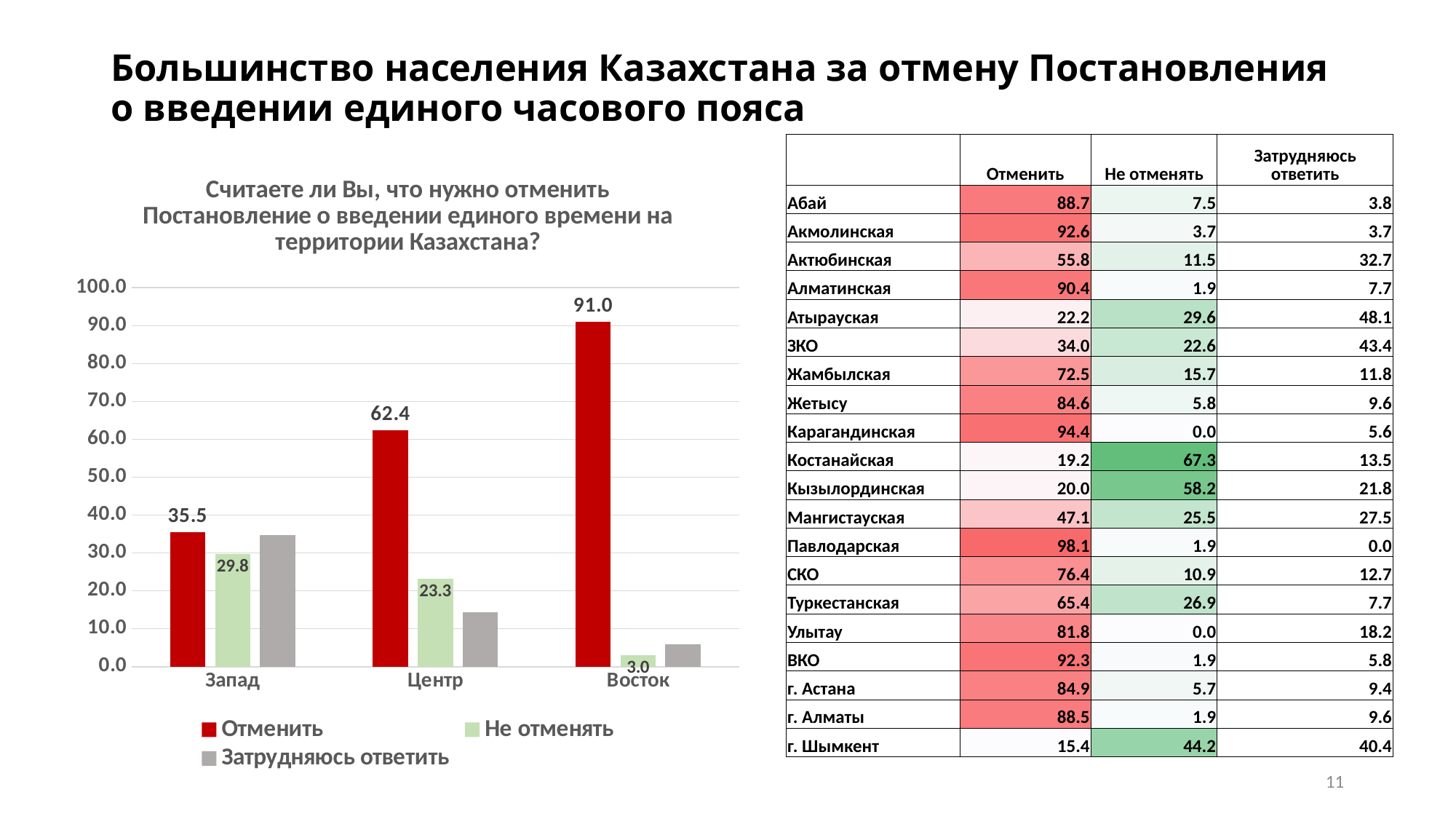
Is the value of Затрудняюсь ответить for Восток greater or less than 10.0? less Is the value of Затрудняюсь ответить for Центр greater or less than 20.0? less What is the value of Отменить for Центр? 62.4 Which region has the lowest value for Не отменять? Восток How many regions are shown on the x axis of the chart? 3 Which region has the highest value for Отменить? Восток Does the Отменить value rise or fall from Запад to Восток? rises For Запад, which is larger: Отменить or Не отменять? Отменить What is the difference between the Отменить values for Восток and Запад? 55.5 What is the value of Отменить for Восток? 91.0 What is the value of Не отменять for Запад? 29.8 How many series does the chart legend list? 3